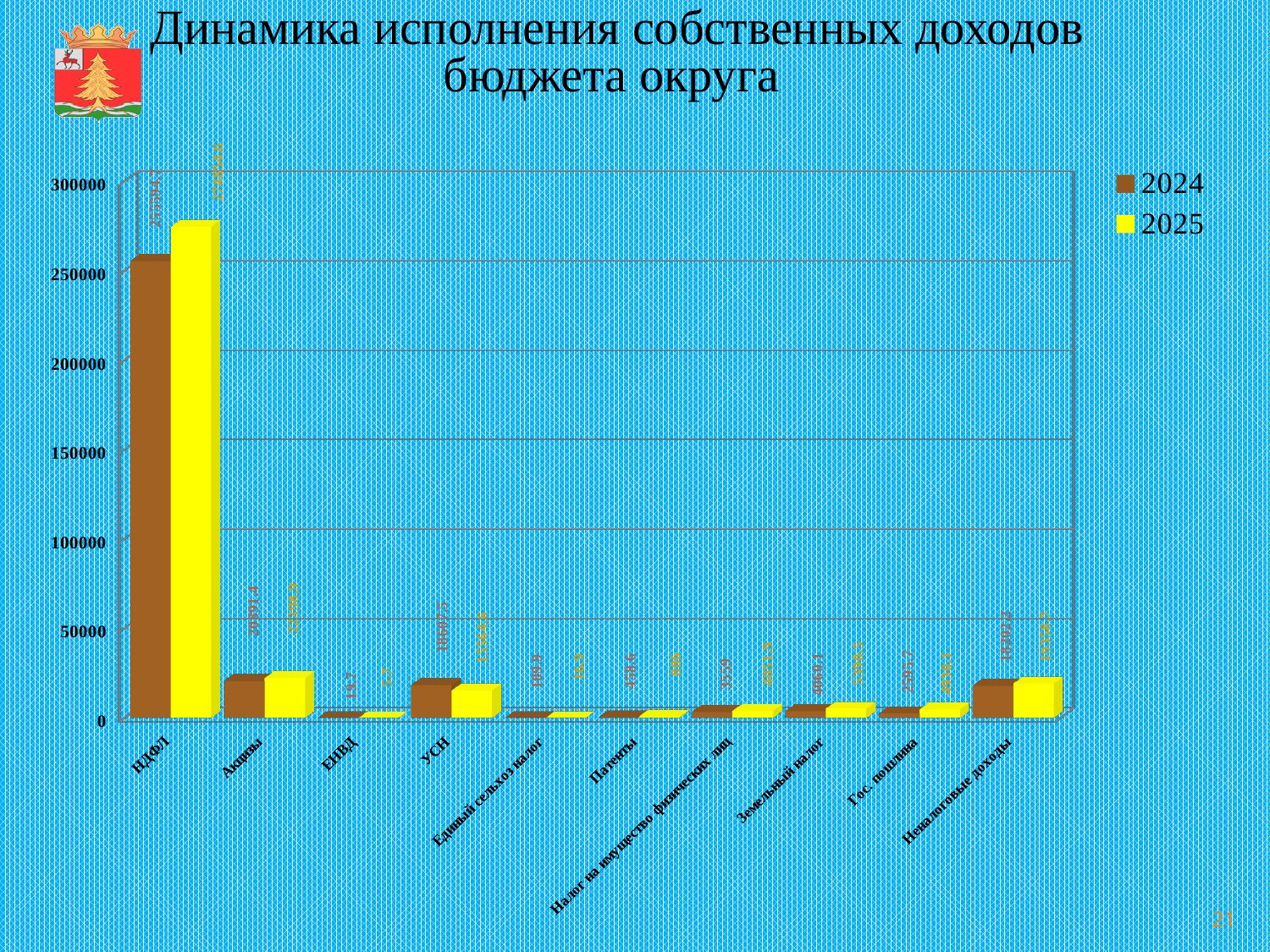
What kind of chart is shown on the slide? bar chart How many series does the legend list? 2 What are the series names in the legend? 2024, 2025 For НДФЛ, which year has the larger value, 2024 or 2025? 2025 How many categories are shown on the x axis? 10 Is the 2024 value for НДФЛ greater or less than 200000? greater Is the 2025 value for НДФЛ greater or less than 250000? greater Which category has the lowest values in both years? ЕНВД Which category has the highest value for 2024? НДФЛ Is the 2024 value for Акцизы greater or less than 50000? less Which category has the highest value for 2025? НДФЛ For УСН, which year has the larger value, 2024 or 2025? 2024